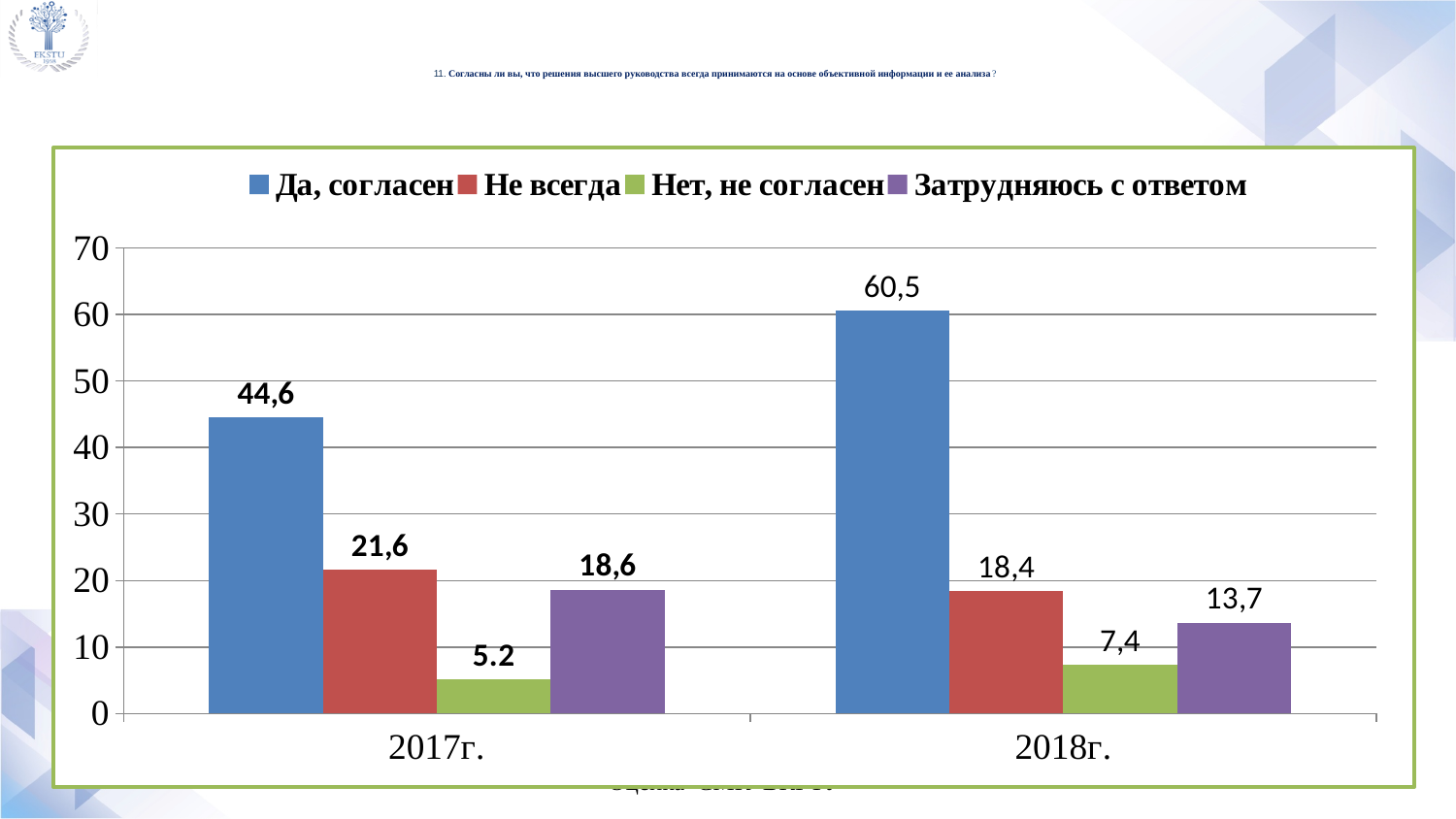
What is the value for "Затрудняюсь с ответом" in 2018г.? 13,7 What is the value for "Нет, не согласен" in 2017г.? 5.2 Is the value for "Да, согласен" in 2018г. greater or less than 50? greater Which series has the highest value in 2018г.? Да, согласен What kind of chart is shown on the slide? bar chart What is the difference between the "Да, согласен" values for 2018г. and 2017г.? 15,9 Which series has the lowest value in 2017г.? Нет, не согласен What colour are the bars for "Затрудняюсь с ответом"? purple What is the value for "Да, согласен" in 2017г.? 44,6 How many categories are shown on the x axis? 2 Which is larger: "Не всегда" in 2017г. or "Не всегда" in 2018г.? Не всегда in 2017г. How many series does the legend list? 4